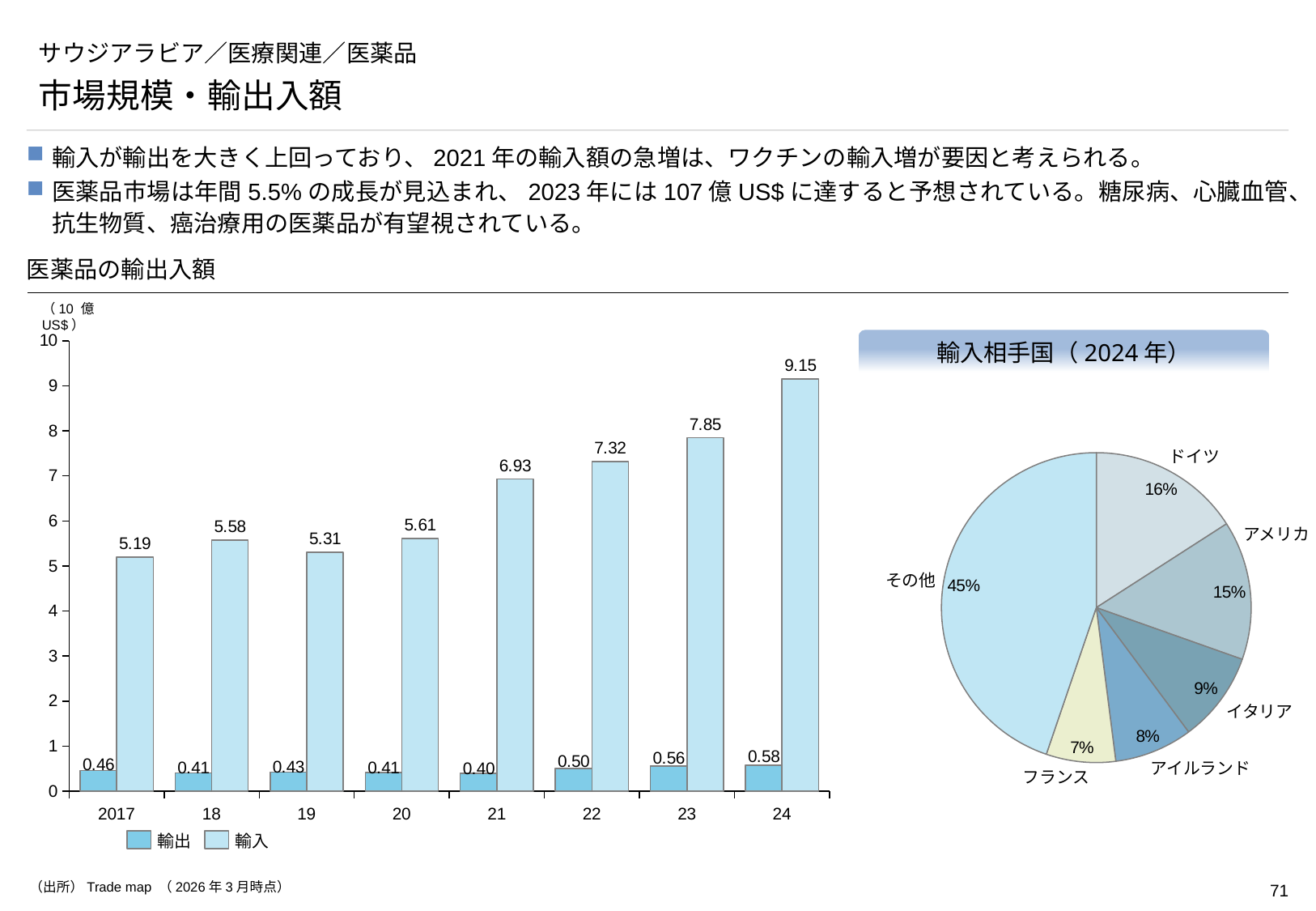
In the bar chart 医薬品の輸出入額, what is the 輸入 value for 2021? 6.93 In the pie chart 輸入相手国（2024年）, what share does ドイツ have? 16% In the bar chart 医薬品の輸出入額, how many years are shown on the x axis? 8 What kind of chart is 輸入相手国（2024年）? pie chart In the bar chart 医薬品の輸出入額, which year has the highest 輸入 value? 24 In the bar chart 医薬品の輸出入額, is the 輸入 value for 2017 larger or the 輸入 value for 19? 19 In the bar chart 医薬品の輸出入額, what is the 輸出 value for 2017? 0.46 In the bar chart 医薬品の輸出入額, which year has the lowest 輸出 value? 21 In the bar chart 医薬品の輸出入額, does the 輸入 value rise or fall from 21 to 24? rise In the bar chart 医薬品の輸出入額, how many series does the legend list? 2 In the pie chart 輸入相手国（2024年）, which country (excluding その他) has the smallest share? フランス In the bar chart 医薬品の輸出入額, what is the difference between the 輸入 values for 24 and 23? 1.30